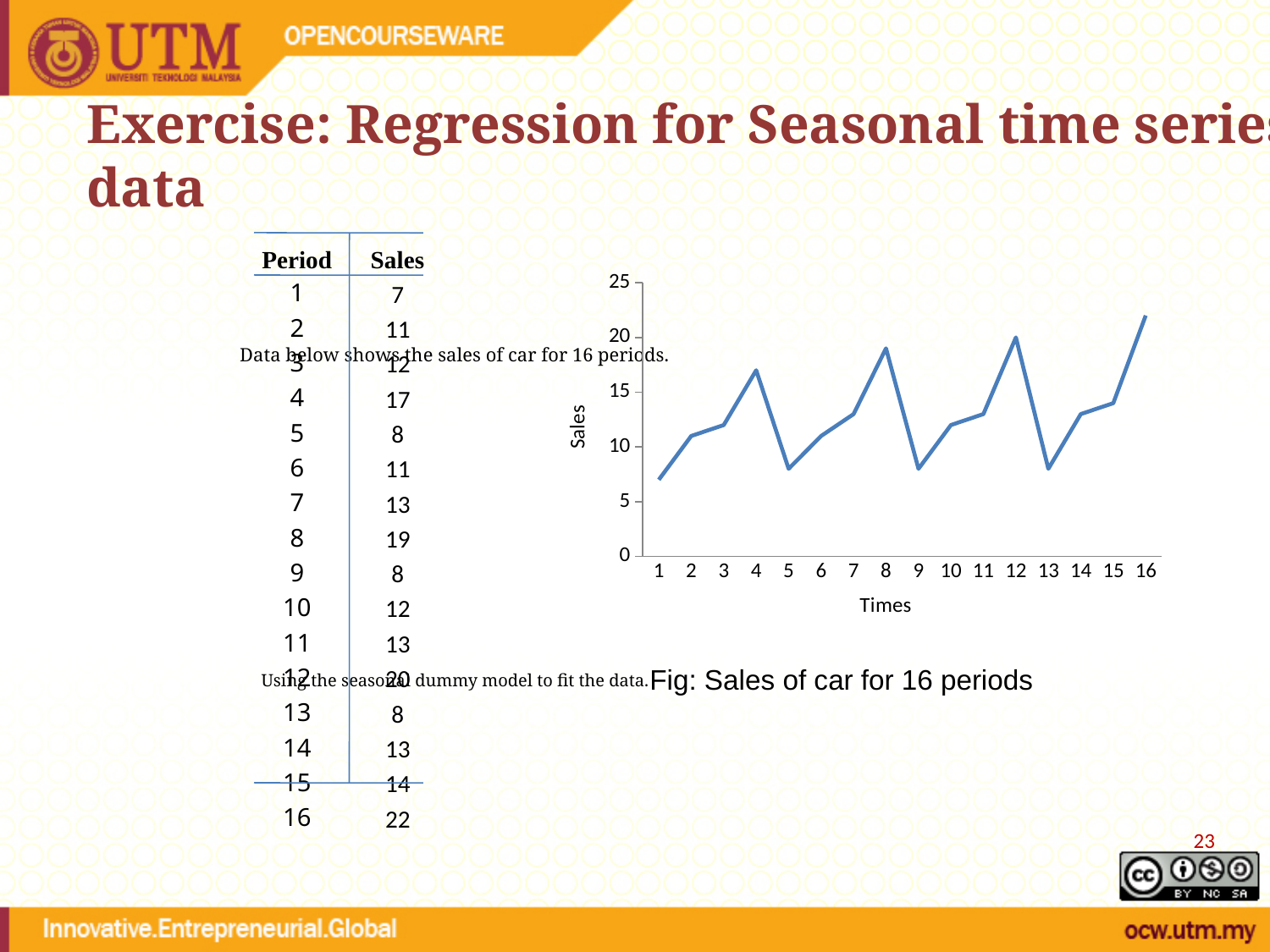
What is the difference between the sales at period 16 and the sales at period 1? 15 What is the label on the x axis of the chart? Times Which period has higher sales, period 4 or period 8? period 8 What is the label on the y axis of the chart? Sales Is the sales value at period 5 greater or less than 10? less What kind of chart is shown on the slide? line chart What is the sales value at period 8? 19 At which time period does the sales line reach its highest value? 16 Is the sales value at period 16 greater or less than 20? greater At which time period does the sales line reach its lowest value? 1 How many time periods are plotted on the x axis of the chart? 16 What is the sales value at period 4? 17